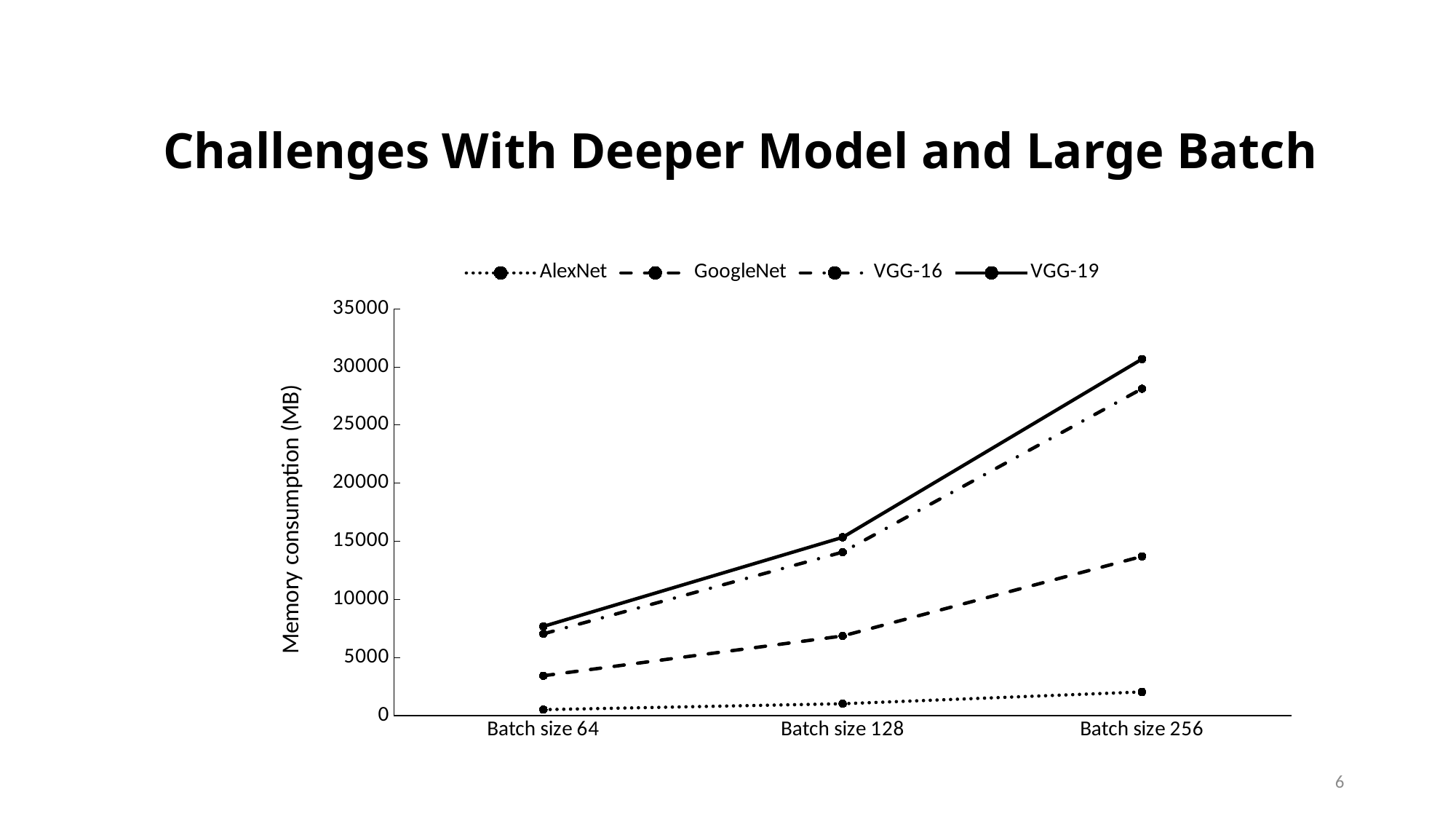
Does the memory consumption of VGG-19 rise or fall as the batch size increases? rise Is the memory consumption of VGG-19 at batch size 256 greater or less than 25000? greater Which model has the highest memory consumption at batch size 256? VGG-19 Is the memory consumption of GoogleNet at batch size 256 greater or less than 15000? less How many batch sizes are plotted along the x axis? 3 Which model has the lowest memory consumption at batch size 256? AlexNet Is the memory consumption of VGG-16 at batch size 64 greater or less than 5000? greater At batch size 128, which has higher memory consumption, VGG-16 or GoogleNet? VGG-16 How many series does the legend list? 4 What is the label of the y axis? Memory consumption (MB) What kind of chart is shown on the slide? line chart